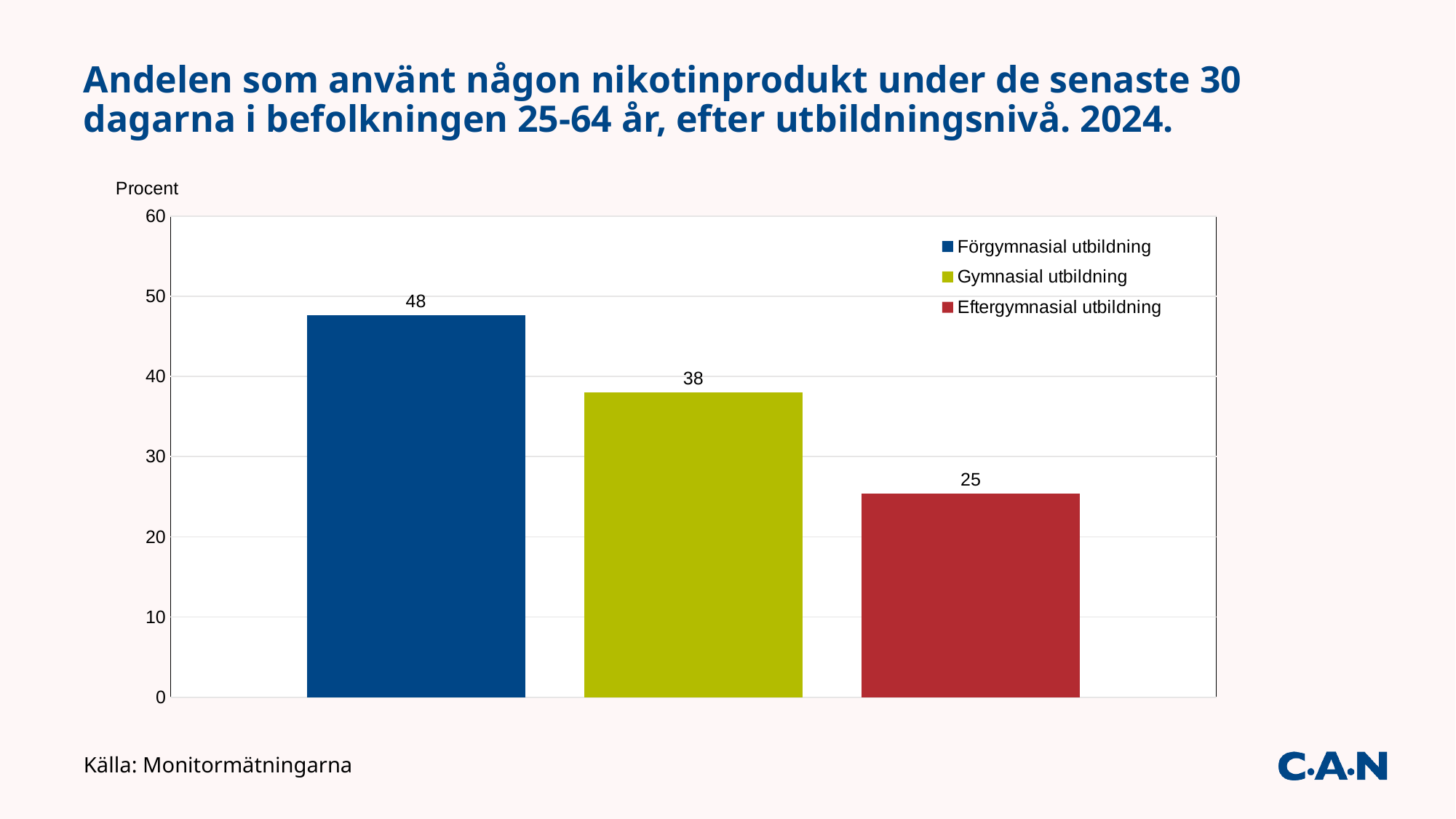
What is the difference between the values for Förgymnasial utbildning and Eftergymnasial utbildning? 23 What kind of chart is shown on the slide? bar chart How many entries does the legend list? 3 What is the difference between the values for Gymnasial utbildning and Eftergymnasial utbildning? 13 Is the value for Gymnasial utbildning greater or less than 40? less Which is larger, the value for Gymnasial utbildning or Eftergymnasial utbildning? Gymnasial utbildning What is the value for Gymnasial utbildning? 38 How many bars are shown in the chart? 3 What is the value for Eftergymnasial utbildning? 25 What is the value for Förgymnasial utbildning? 48 Which education level has the highest share? Förgymnasial utbildning Which education level has the lowest share? Eftergymnasial utbildning